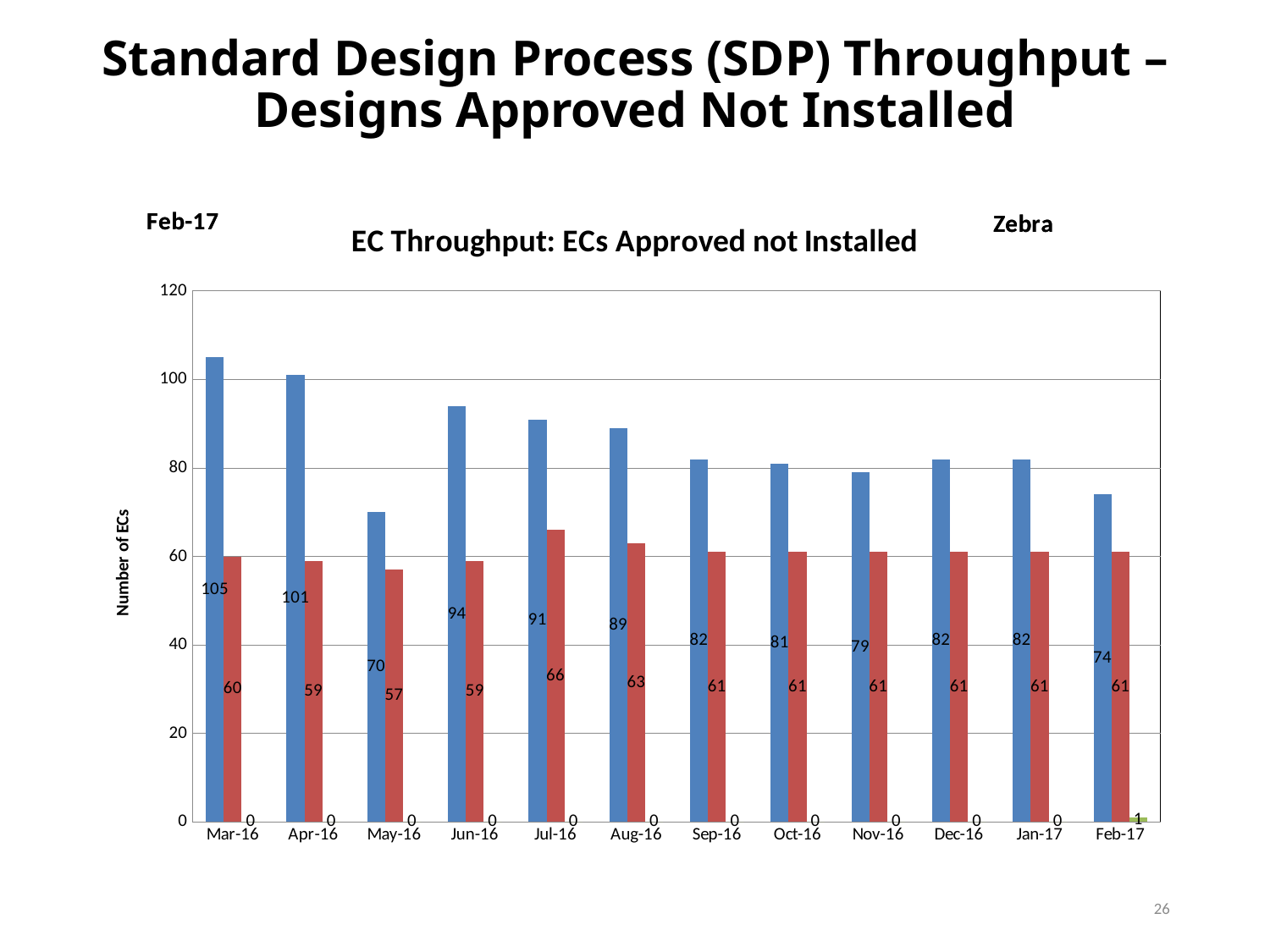
What kind of chart is shown on the slide? Bar chart What is the value of the blue bar for Mar-16? 105 What is the value of the green bar for Feb-17? 1 How many months are shown on the x axis? 12 What is the difference between the blue bar and the red bar for Mar-16? 45 What is the label on the vertical axis of the chart? Number of ECs What is the difference between the blue bar values for Apr-16 and May-16? 31 Which month has the highest blue bar? Mar-16 Which month has the lowest blue bar? May-16 Which is larger, the blue bar for Jun-16 or the blue bar for Feb-17? Jun-16 What is the value of the red bar for Jul-16? 66 Which month has the lowest red bar? May-16